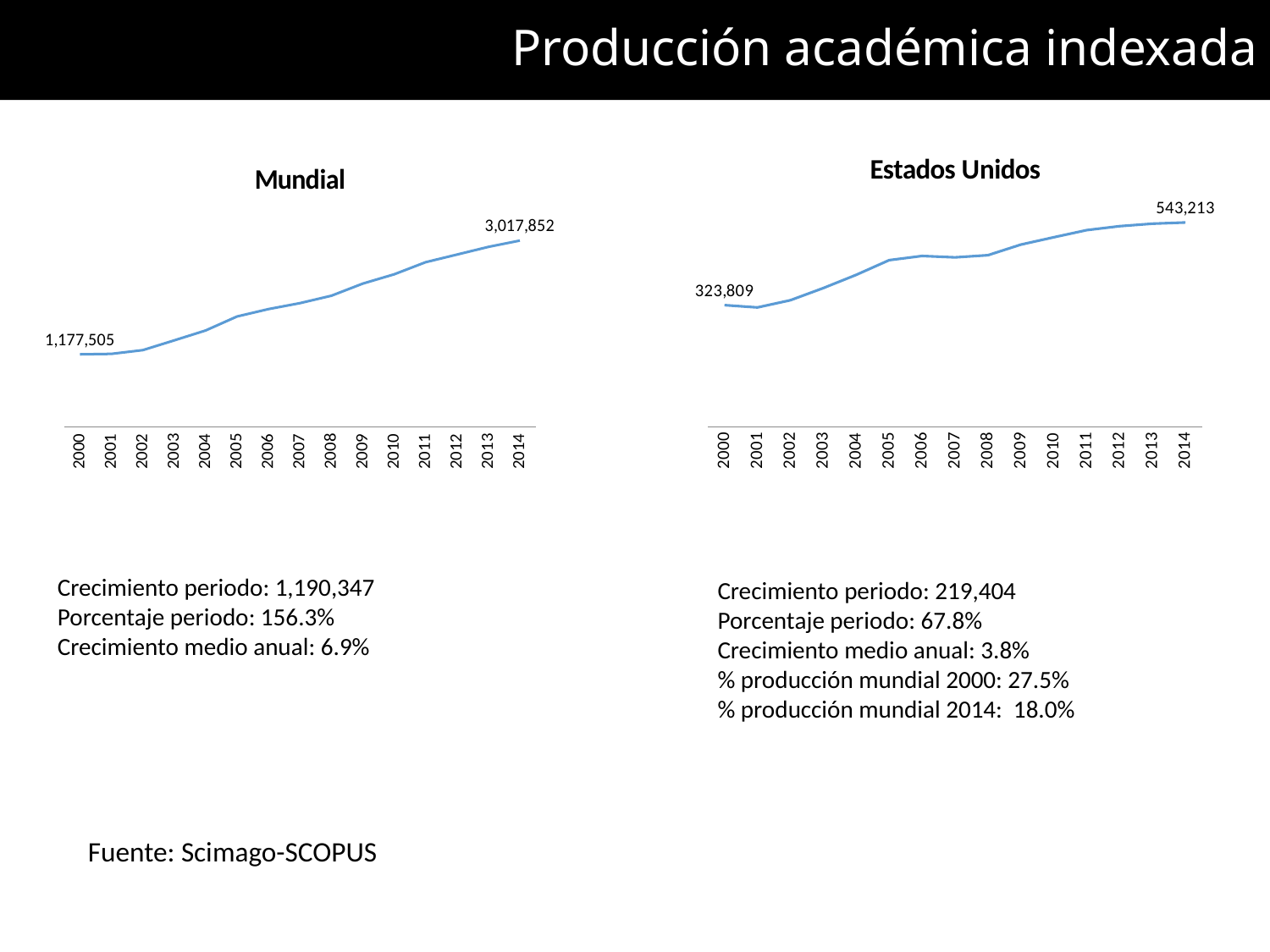
What is the title of the chart on the right side of the slide? Estados Unidos In the Estados Unidos chart, what is the difference between the 2014 value and the 2000 value? 219,404 How many years are shown on the x axis of the Mundial chart? 15 What kind of chart is the Estados Unidos chart? line chart In the Estados Unidos chart, what is the value for 2014? 543,213 In the Mundial chart, which year has the highest value? 2014 In the Mundial chart, is the value for 2014 larger or smaller than the value for 2000? larger In the Estados Unidos chart, which year has the highest value? 2014 In the Mundial chart, what is the value for 2014? 3,017,852 In the Mundial chart, what is the value for 2000? 1,177,505 In the Estados Unidos chart, what is the value for 2000? 323,809 In the Mundial chart, do the values generally rise or fall from 2000 to 2014? rise